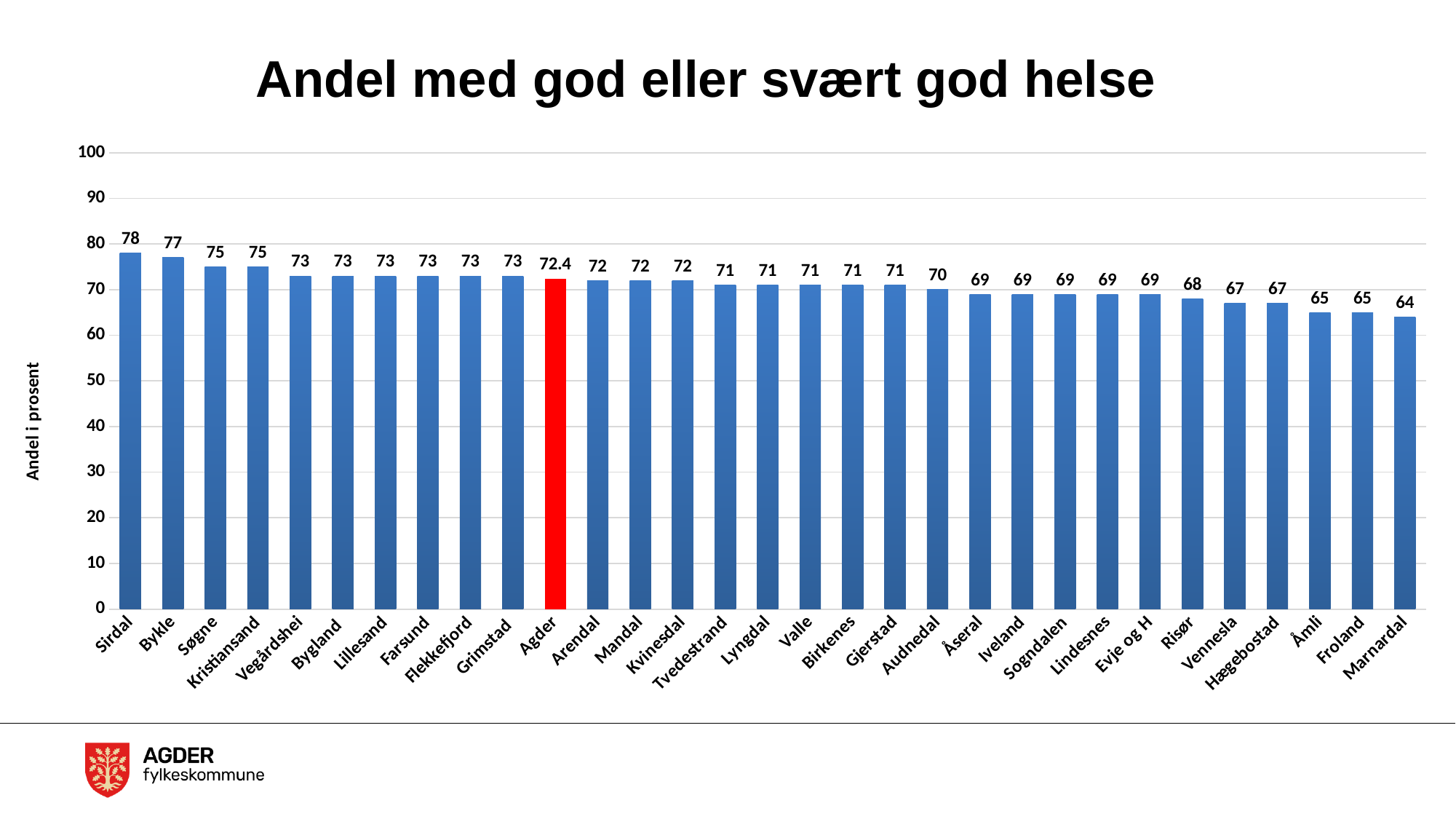
Do the values rise or fall from left to right along the x axis? Fall How many categories are shown on the x axis? 31 What is the value for Agder? 72.4 Which is larger, the value for Kristiansand or the value for Vennesla? Kristiansand Which category has the lowest value? Marnardal What is the difference between the values for Bykle and Audnedal? 7 Which category has the highest value? Sirdal What kind of chart is this? Bar chart What is the difference between the values for Sirdal and Marnardal? 14 What is the value for Risør? 68 What is the title of the chart? Andel med god eller svært god helse What is the value for Sirdal? 78